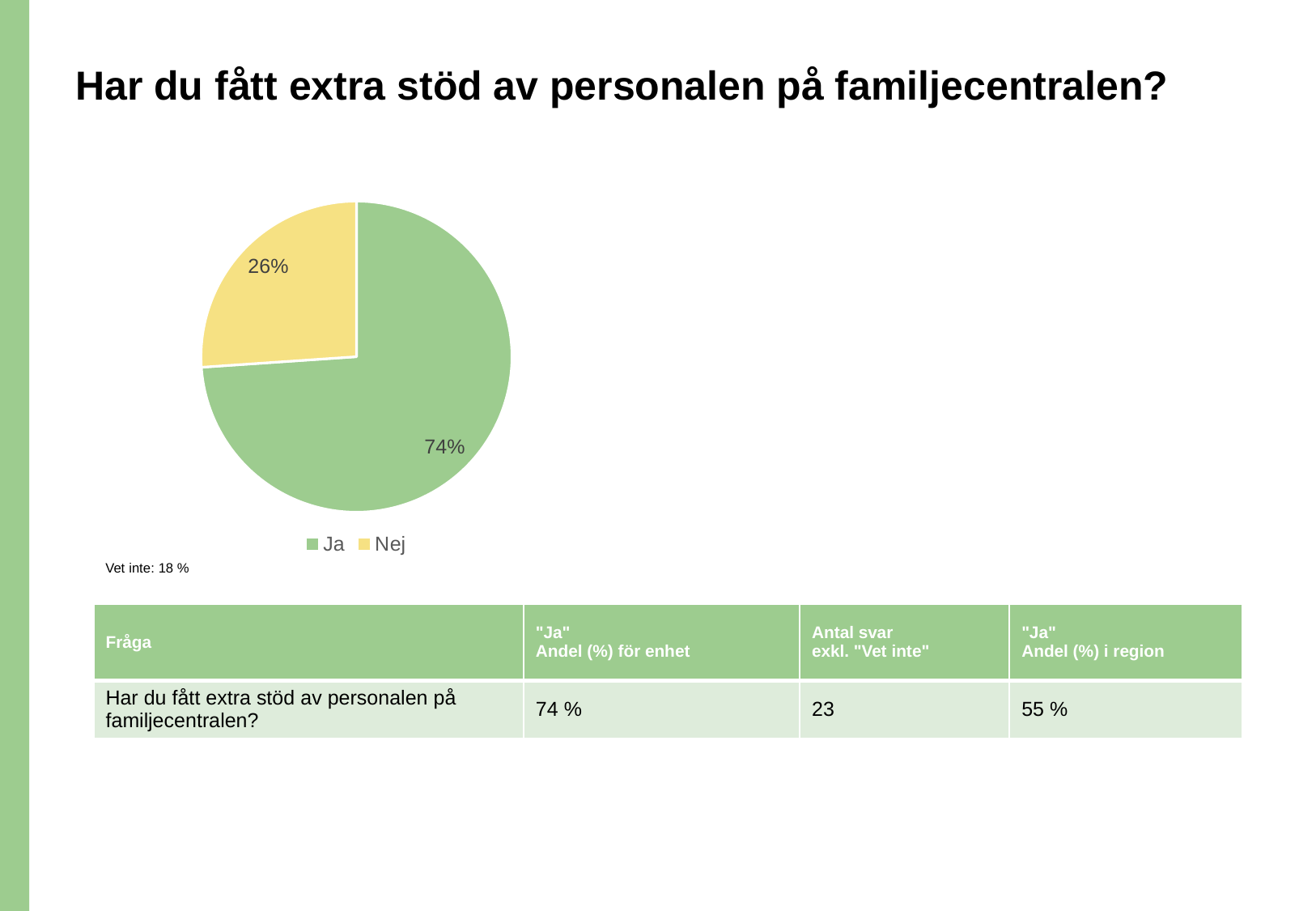
Which slice of the pie is the largest? Ja What is the difference in percentage points between the "Ja" and "Nej" slices? 48 What colour is the "Ja" slice in the pie chart? green How many slices does the pie chart have? 2 What kind of chart is shown on the slide? pie chart Which is larger, the "Ja" slice or the "Nej" slice? Ja What share of the pie does "Nej" represent? 26% Which slice of the pie is the smallest? Nej What colour is the "Nej" slice in the pie chart? yellow How many entries does the legend list? 2 What share of the pie does "Ja" represent? 74%